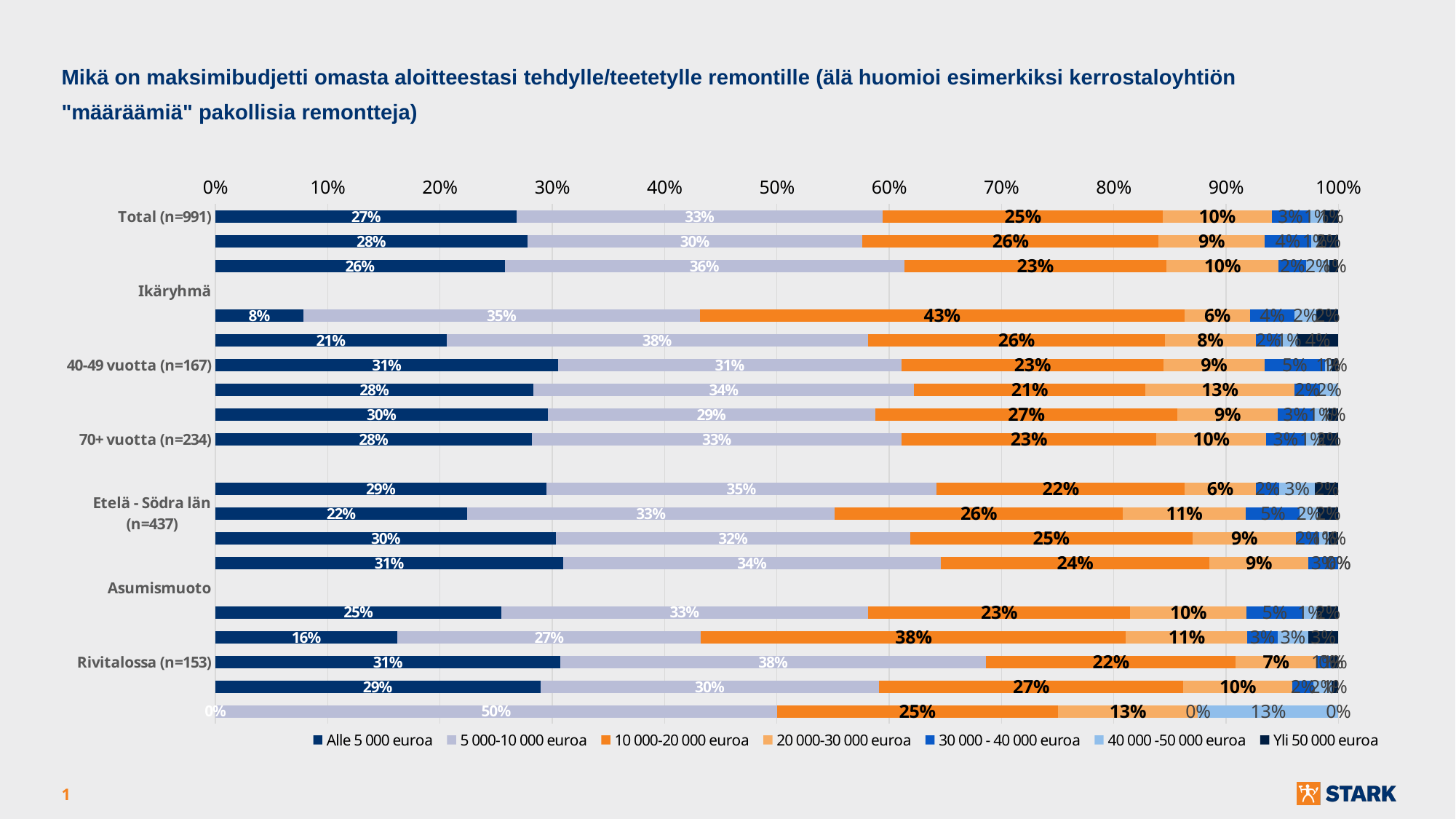
What is the value of '20 000-30 000 euroa' for Etelä - Södra län (n=437)? 11% Which legend entry is shown in orange? 10 000-20 000 euroa What is the value of '10 000-20 000 euroa' for 40-49 vuotta (n=167)? 23% What is the value of '5 000-10 000 euroa' for Rivitalossa (n=153)? 38% What is the value of '5 000-10 000 euroa' for Total (n=991)? 33% What kind of chart is shown on the slide? stacked bar chart Which is larger for 70+ vuotta (n=234): 'Alle 5 000 euroa' or '10 000-20 000 euroa'? Alle 5 000 euroa What is the value of '20 000-30 000 euroa' for 70+ vuotta (n=234)? 10% How many series does the legend list? 7 Which budget category has the largest share for Rivitalossa (n=153)? 5 000-10 000 euroa What is the difference between the '5 000-10 000 euroa' and '10 000-20 000 euroa' values for Etelä - Södra län (n=437)? 7% What is the value of 'Alle 5 000 euroa' for Total (n=991)? 27%